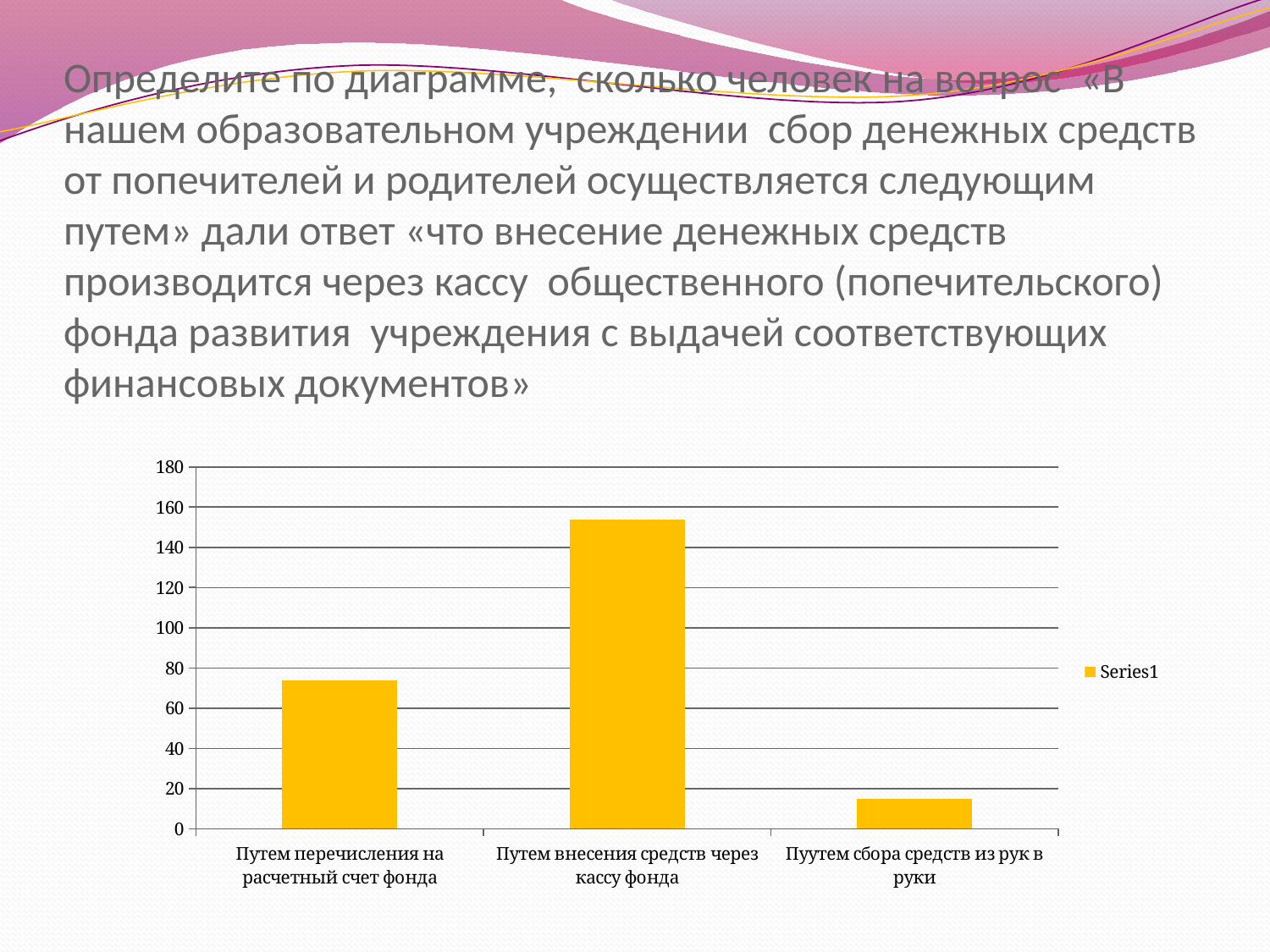
How many series does the chart legend list? 1 What is the name of the series shown in the chart legend? Series1 Is the value for "Путем внесения средств через кассу фонда" greater or less than 160? less Is the value for "Путем перечисления на расчетный счет фонда" greater or less than 60? greater Which category has the highest bar in the chart? Путем внесения средств через кассу фонда What kind of chart is shown on the slide? bar chart Is the value for "Путем внесения средств через кассу фонда" greater or less than 140? greater How many categories are shown on the x axis of the chart? 3 Which is larger: the value for "Путем перечисления на расчетный счет фонда" or the value for "Пуутем сбора средств из рук в руки"? Путем перечисления на расчетный счет фонда Which category has the lowest bar in the chart? Пуутем сбора средств из рук в руки